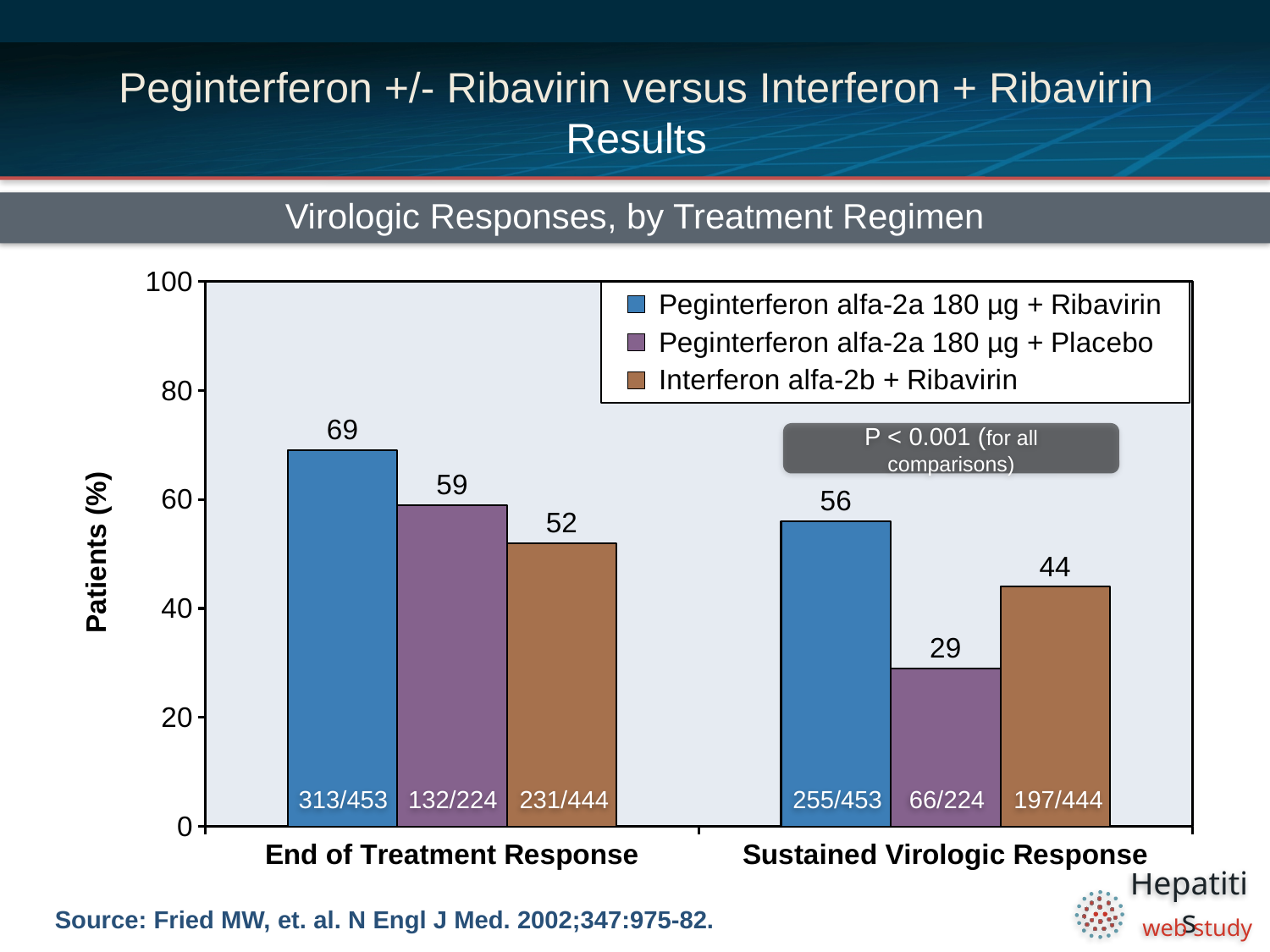
Which series has the lowest value in the End of Treatment Response category? Interferon alfa-2b + Ribavirin What fraction is printed inside the Peginterferon alfa-2a 180 µg + Ribavirin bar in the Sustained Virologic Response category? 255/453 How many categories are shown on the x axis? 2 How many series does the legend list? 3 Which is larger: the Sustained Virologic Response value for Interferon alfa-2b + Ribavirin or for Peginterferon alfa-2a 180 µg + Placebo? Interferon alfa-2b + Ribavirin What is the value for Peginterferon alfa-2a 180 µg + Ribavirin in the End of Treatment Response category? 69 Which series has the highest value in the Sustained Virologic Response category? Peginterferon alfa-2a 180 µg + Ribavirin What is the value for Interferon alfa-2b + Ribavirin in the Sustained Virologic Response category? 44 What kind of chart is shown on the slide? Bar chart What is the label of the y axis? Patients (%) What is the difference between the End of Treatment Response and Sustained Virologic Response values for Peginterferon alfa-2a 180 µg + Placebo? 30 What is the value for Peginterferon alfa-2a 180 µg + Placebo in the Sustained Virologic Response category? 29